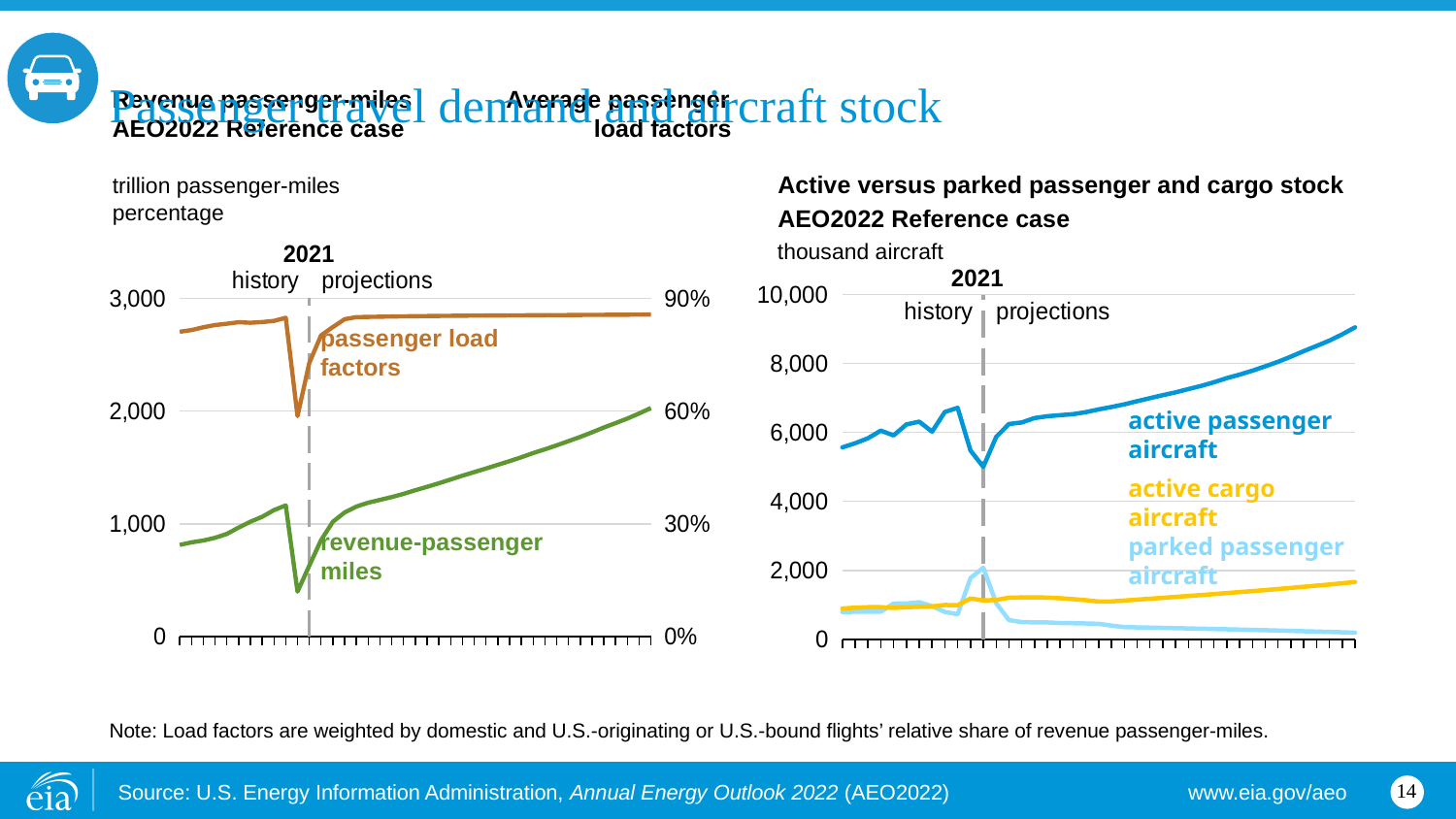
How many series are labelled on the 'Active versus parked passenger and cargo stock' chart? 3 On the left chart, is the value for revenue-passenger miles at its 2020 low point greater or less than 1,000 trillion passenger-miles? less What kind of chart is the 'Active versus parked passenger and cargo stock' chart on the right? line chart On the 'Active versus parked passenger and cargo stock' chart, do parked passenger aircraft rise or fall over the projection period? fall On the 'Active versus parked passenger and cargo stock' chart, is the value for active passenger aircraft at the end of the projection period greater or less than 8,000? greater On the 'Active versus parked passenger and cargo stock' chart, is the value for active cargo aircraft at the end of the projection period greater or less than 2,000? less On the 'Active versus parked passenger and cargo stock' chart, do active passenger aircraft rise or fall over the projection period? rise What year does the vertical dashed line separating history from projections mark on both charts? 2021 On the 'Active versus parked passenger and cargo stock' chart, which series is higher at the end of the projection period: active passenger aircraft or active cargo aircraft? active passenger aircraft How many series are labelled on the left chart showing revenue passenger-miles and load factors? 2 On the left chart, do revenue-passenger miles rise or fall over the projection period? rise